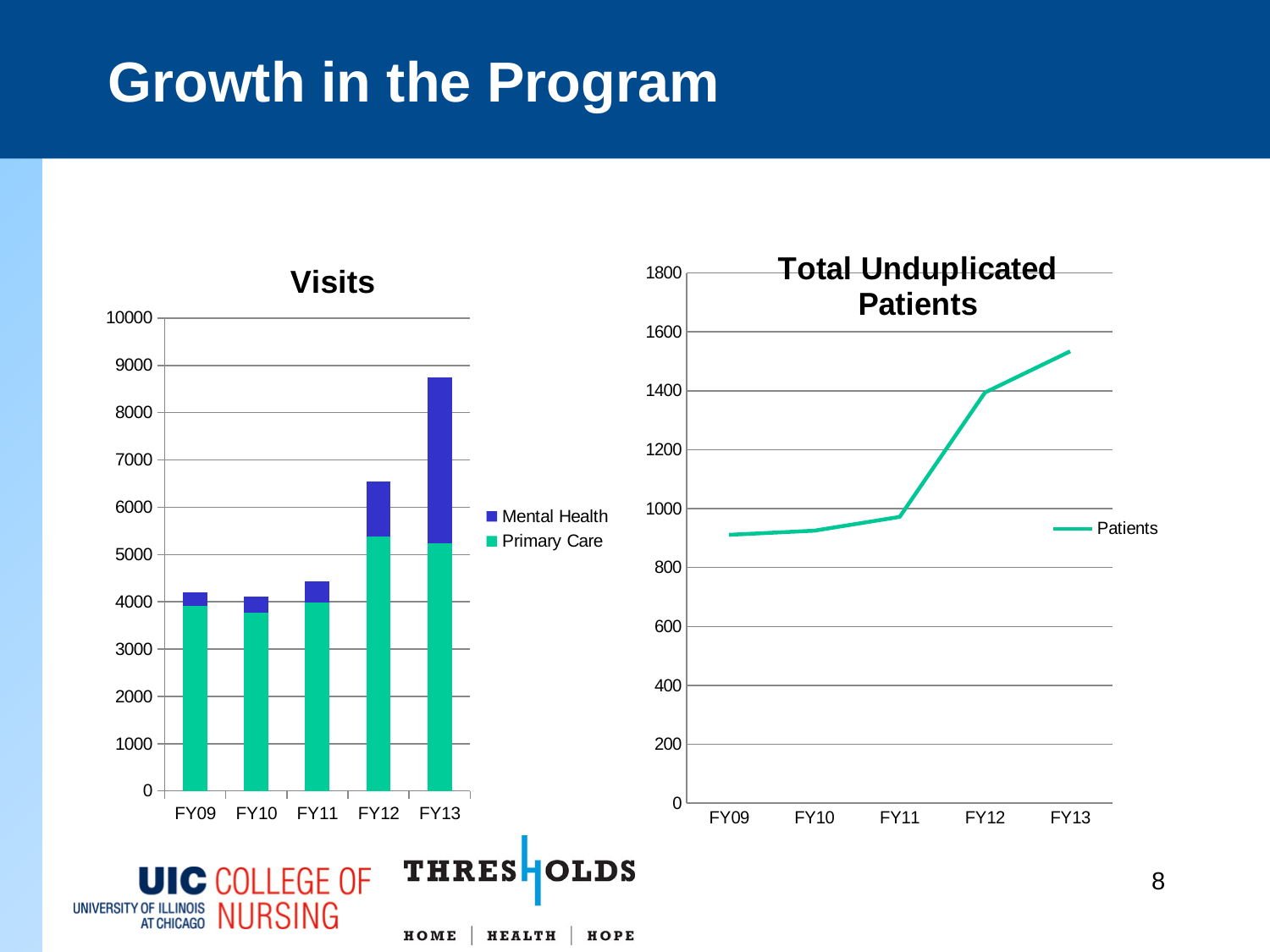
What kind of chart is the "Visits" chart? bar chart In the "Total Unduplicated Patients" chart, which fiscal year has the highest value? FY13 What kind of chart is the "Total Unduplicated Patients" chart? line chart In the "Total Unduplicated Patients" chart, is the value for FY13 greater or less than 1400? greater In the "Visits" chart, how many series does the legend list? 2 In the "Visits" chart, which fiscal year has the highest total visits? FY13 In the "Visits" chart, which fiscal year has the largest Mental Health segment? FY13 In the "Visits" chart, is the total bar for FY12 larger than the total bar for FY11? yes In the "Visits" chart, how many fiscal years are shown on the x axis? 5 In the "Visits" chart, is the total bar for FY13 greater or less than 8000? greater In the "Visits" chart, is the total bar for FY11 greater or less than 5000? less In the "Total Unduplicated Patients" chart, do the values rise or fall from FY09 to FY13? rise